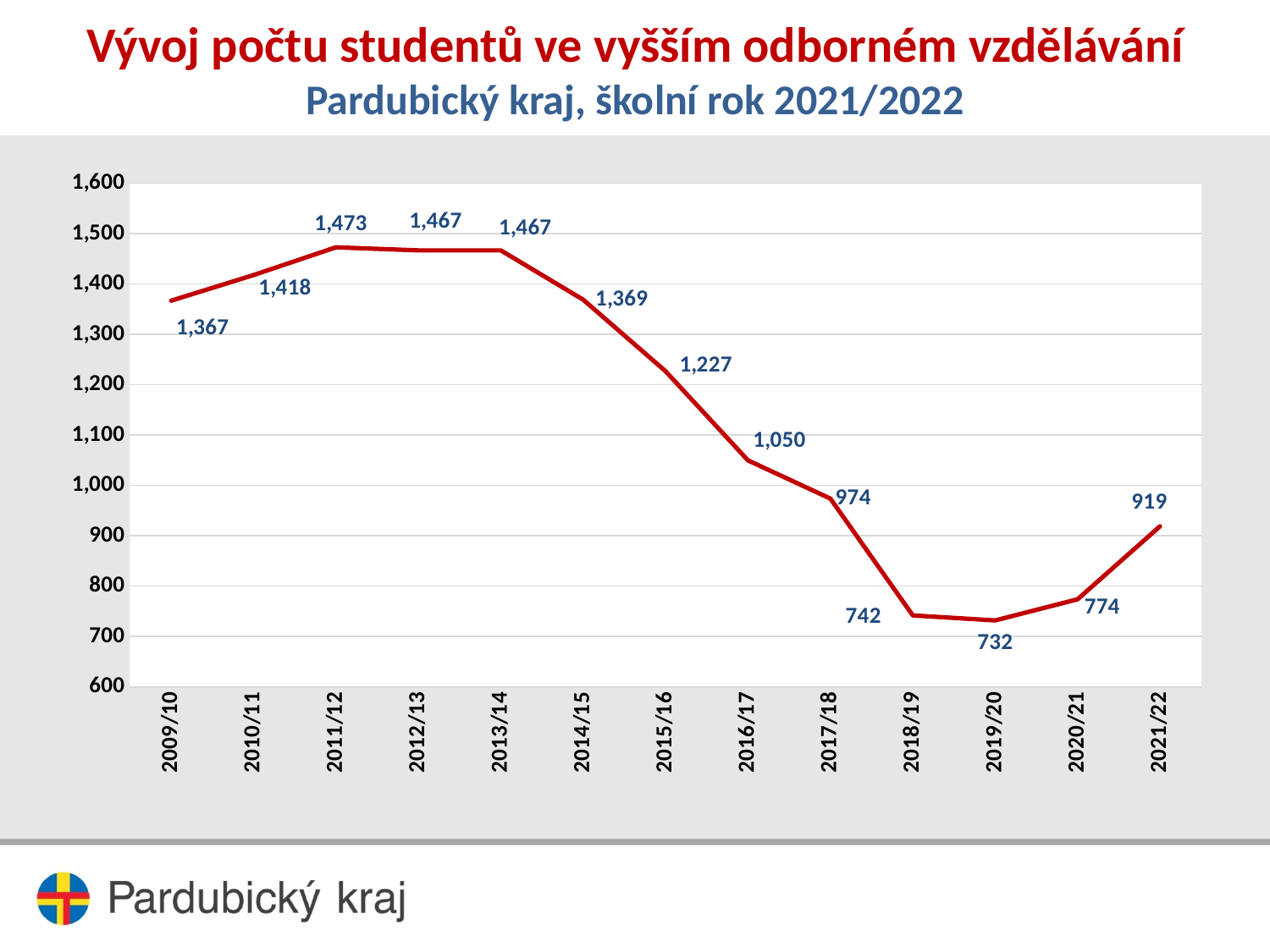
What is the difference between the values for 2020/21 and 2021/22? 145 What kind of chart is shown on the slide? Line chart How many school years are plotted on the chart? 13 What is the value for 2016/17? 1,050 Which school year has the lowest number of students? 2019/20 What is the difference between the values for 2011/12 and 2019/20? 741 Which school year has the highest number of students? 2011/12 What is the title of the chart? Vývoj počtu studentů ve vyšším odborném vzdělávání What is the number of students in 2021/22? 919 What is the number of students in 2009/10? 1,367 Which is larger, the value for 2017/18 or the value for 2021/22? 2017/18 Do the values rise or fall from 2013/14 to 2019/20? Fall